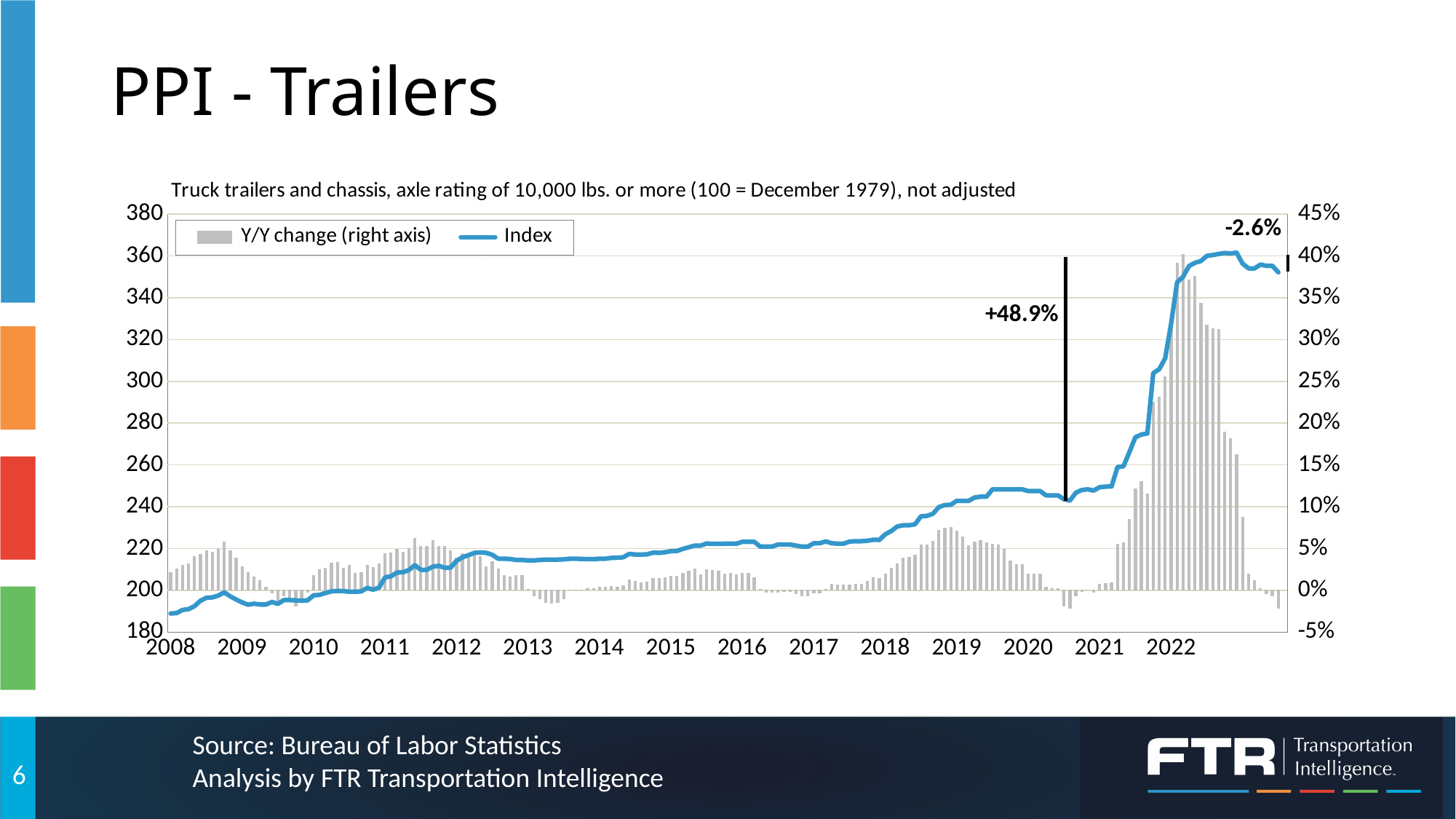
Is the Index value in 2015 greater or less than 240? less Is the peak Index value in 2022 greater or less than 340? greater What percentage change is annotated at the end of the Index line? -2.6% How many year labels are shown on the x axis? 15 What percentage change is annotated at the 2020 low point of the Index line? +48.9% What kind of chart is shown on the slide? A combination line and bar chart Which series is plotted on the right axis according to the legend? Y/Y change Is the highest Y/Y change bar greater or less than 35%? greater Does the Index line rise or fall overall from 2008 to 2022? rise How many series does the legend list? 2 What is the subtitle printed above the chart? Truck trailers and chassis, axle rating of 10,000 lbs. or more (100 = December 1979), not adjusted